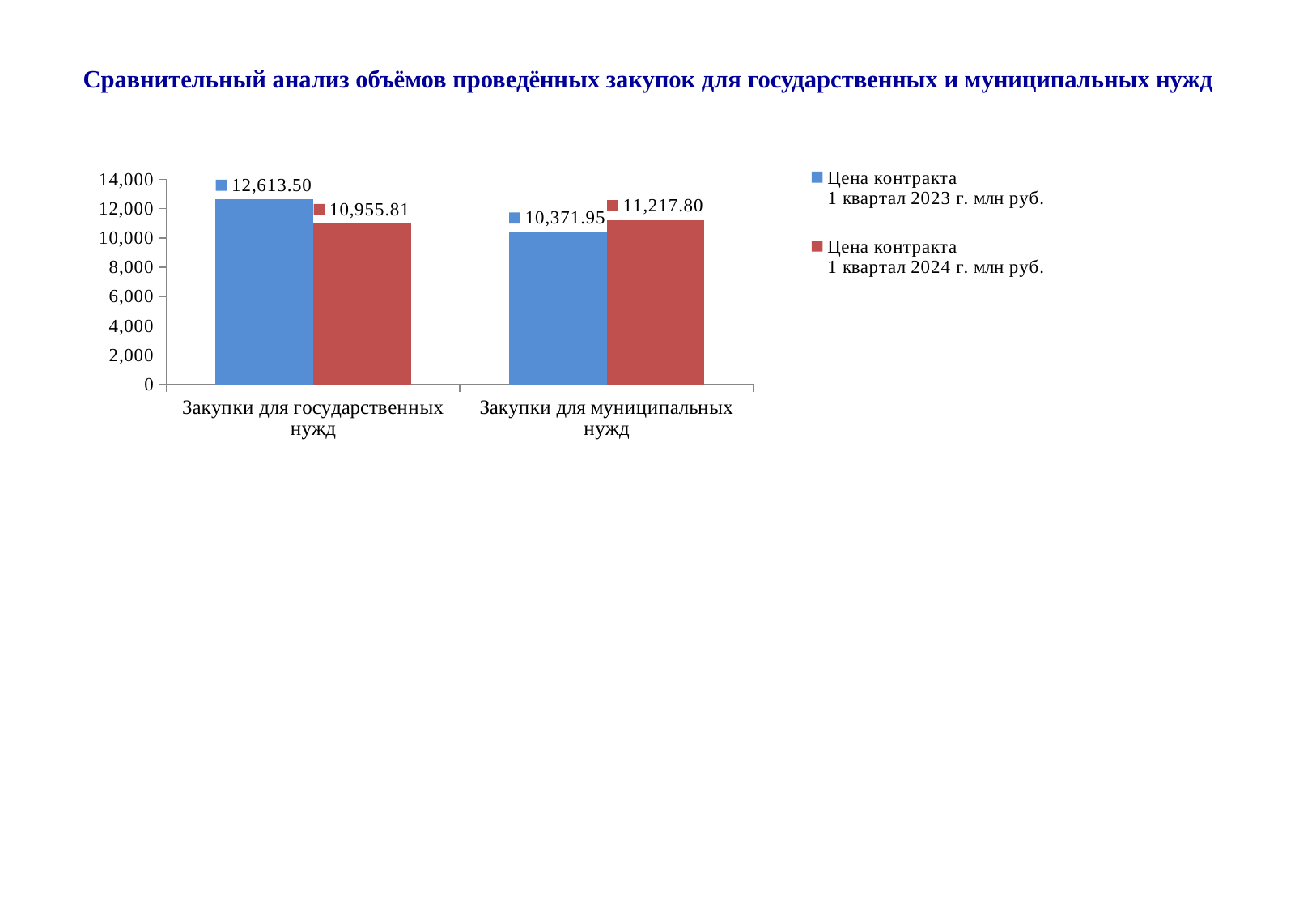
What is the value for 'Закупки для муниципальных нужд' in the series 'Цена контракта 1 квартал 2023 г. млн руб.'? 10,371.95 What kind of chart is shown on the slide? Bar chart How many categories are shown on the x axis? 2 What is the value for 'Закупки для муниципальных нужд' in the series 'Цена контракта 1 квартал 2024 г. млн руб.'? 11,217.80 Which bar has the lowest value on the chart? Закупки для муниципальных нужд, 1 квартал 2023 г. What is the value for 'Закупки для государственных нужд' in the series 'Цена контракта 1 квартал 2024 г. млн руб.'? 10,955.81 What is the difference between the 2023 and 2024 values for 'Закупки для государственных нужд'? 1,657.69 For 'Закупки для муниципальных нужд', which is larger: the 1 квартал 2023 г. value or the 1 квартал 2024 г. value? 1 квартал 2024 г. What is the value for 'Закупки для государственных нужд' in the series 'Цена контракта 1 квартал 2023 г. млн руб.'? 12,613.50 Which bar has the highest value on the chart? Закупки для государственных нужд, 1 квартал 2023 г. How many series does the legend list? 2 What is the difference between the 2024 and 2023 values for 'Закупки для муниципальных нужд'? 845.85